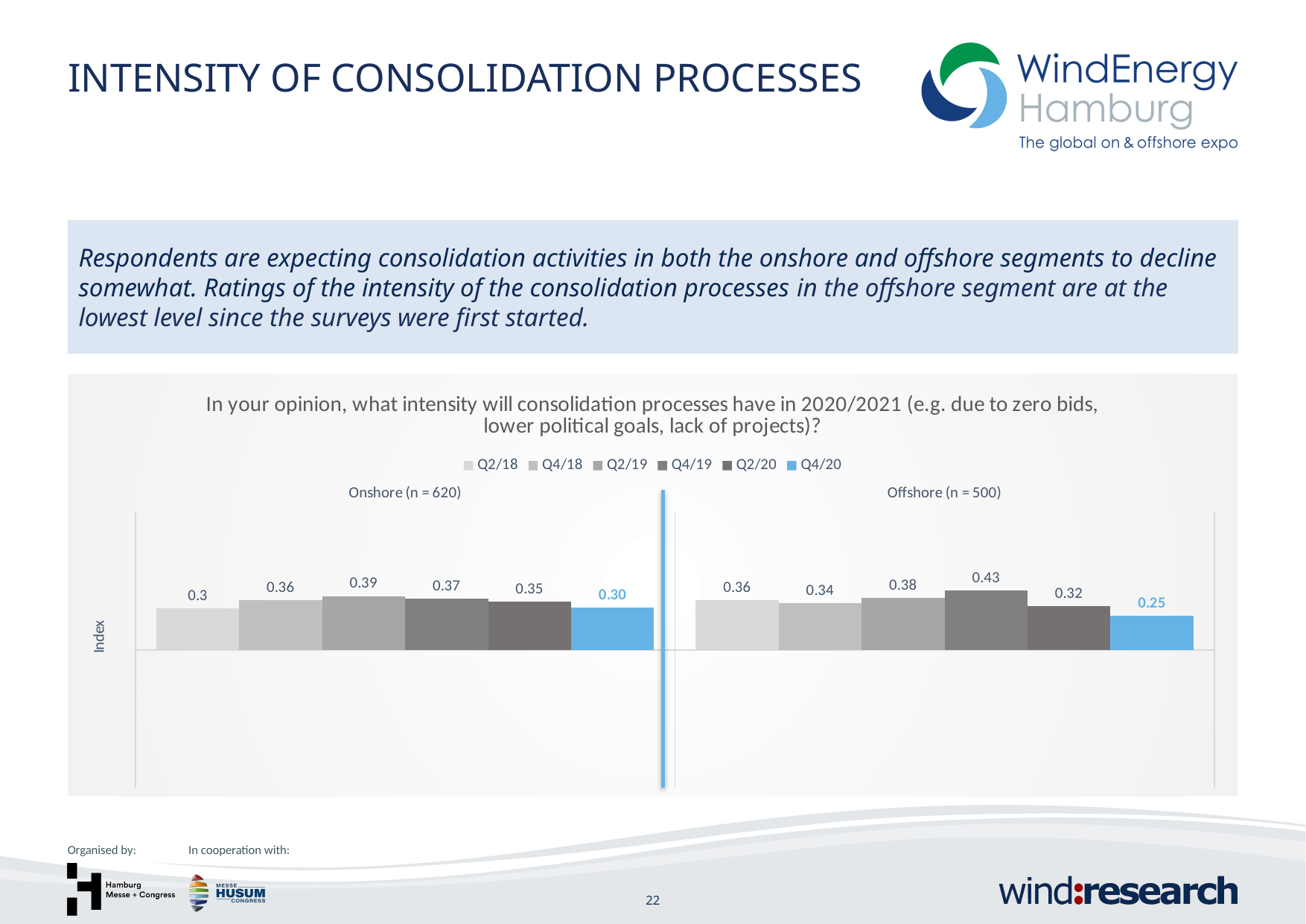
What is the Offshore value for Q4/18? 0.34 What is the difference between the Offshore values for Q4/19 and Q4/20? 0.18 What is the sample size (n) given for the Onshore group? 620 What is the Offshore value for Q4/20? 0.25 Which survey wave has the highest Offshore value? Q4/19 What is the Onshore value for Q2/19? 0.39 Which survey wave has the lowest Onshore value? Q2/18 and Q4/20 (both 0.30) What kind of chart is shown on the slide? Bar chart What is the Onshore value for Q4/20? 0.30 Do the Offshore values rise or fall from Q4/19 to Q4/20? Fall Which is larger, the Onshore value for Q2/20 or the Offshore value for Q2/20? Onshore How many series does the legend list? 6